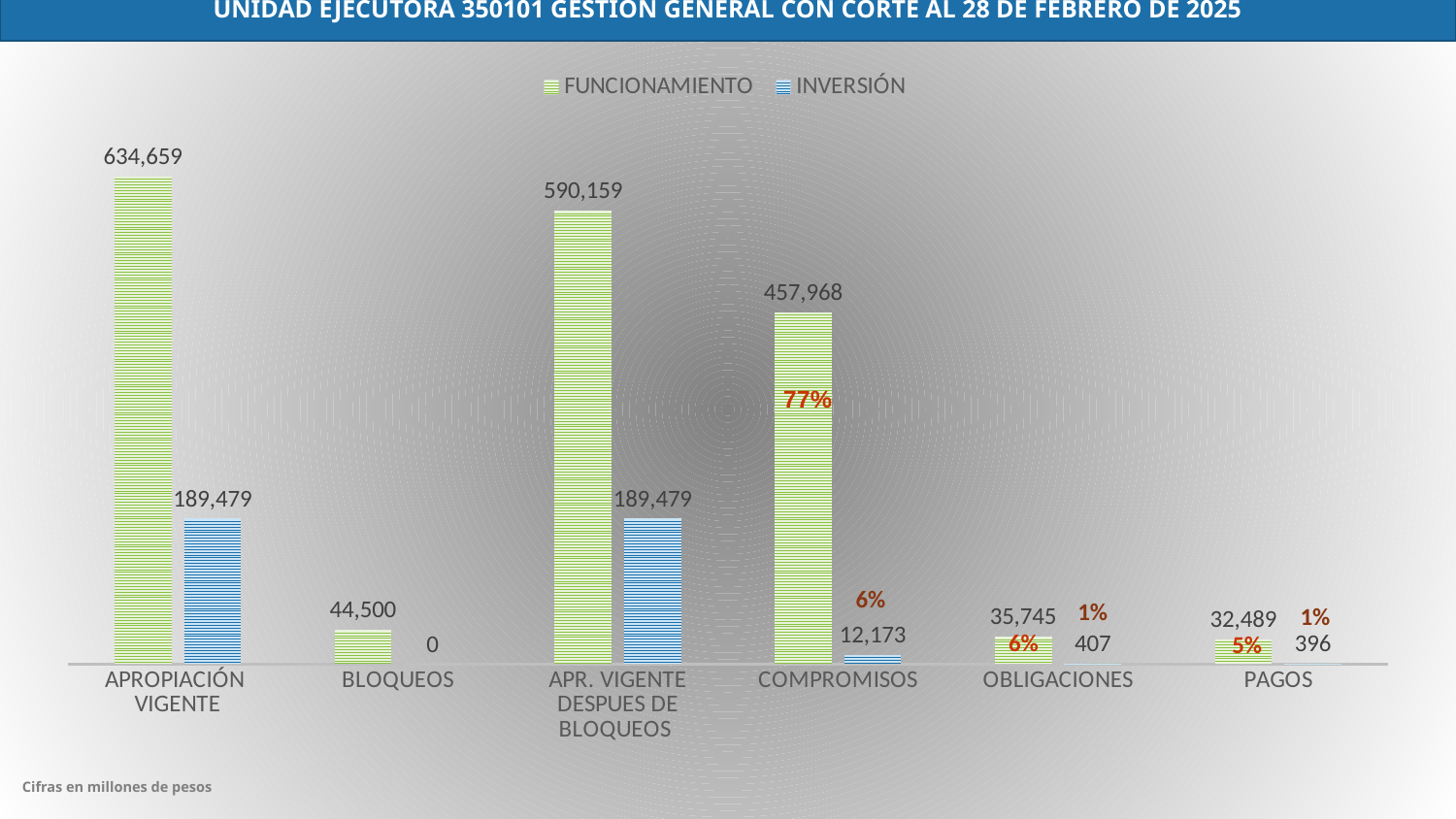
What is the INVERSIÓN value for PAGOS? 396 Which is larger, the INVERSIÓN value for APR. VIGENTE DESPUES DE BLOQUEOS or the FUNCIONAMIENTO value for COMPROMISOS? FUNCIONAMIENTO value for COMPROMISOS What is the FUNCIONAMIENTO value for BLOQUEOS? 44,500 What is the difference between the FUNCIONAMIENTO values for APROPIACIÓN VIGENTE and APR. VIGENTE DESPUES DE BLOQUEOS? 44,500 What is the difference between the FUNCIONAMIENTO values for OBLIGACIONES and PAGOS? 3,256 How many series does the legend list? 2 Which category has the lowest INVERSIÓN value? BLOQUEOS Which category has the highest FUNCIONAMIENTO value? APROPIACIÓN VIGENTE How many categories are shown on the x axis? 6 What type of chart is shown on the slide? Bar chart What is the INVERSIÓN value for COMPROMISOS? 12,173 What is the FUNCIONAMIENTO value for APROPIACIÓN VIGENTE? 634,659